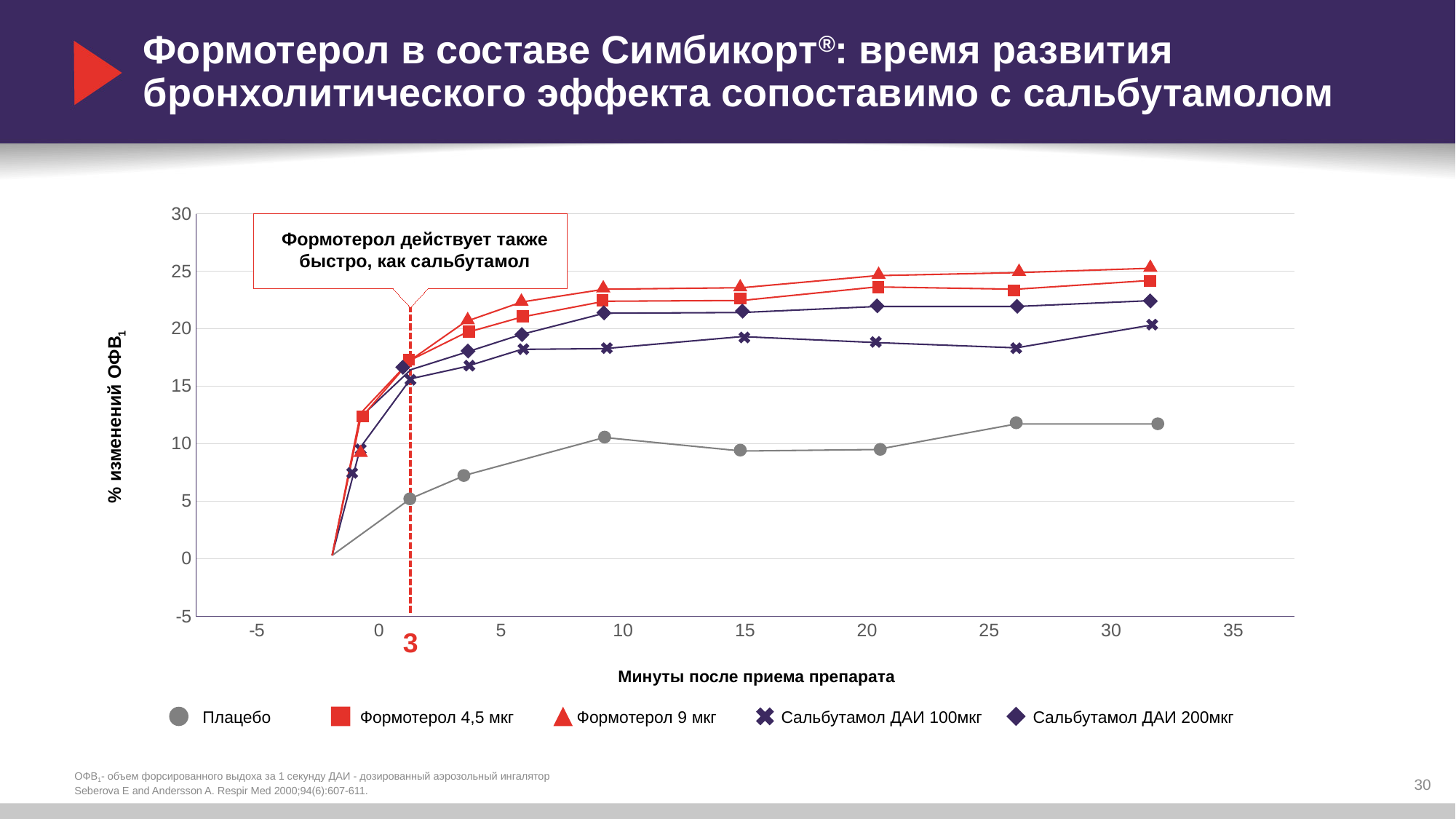
At 30 minutes, which is larger: Сальбутамол ДАИ 200мкг or Сальбутамол ДАИ 100мкг? Сальбутамол ДАИ 200мкг Is the value for Формотерол 9 мкг at 20 minutes greater or less than 20? greater Is the value for Плацебо at 30 minutes greater or less than 15? less What is the title of the x axis? Минуты после приема препарата Which series has the highest value at 30 minutes? Формотерол 9 мкг What kind of chart is shown on the slide? line chart Is the value for Сальбутамол ДАИ 100мкг at 25 minutes greater or less than 20? less Does the Плацебо series rise or fall between 0 and 10 minutes? rise How many series does the legend list? 5 Which series has the lowest values across the whole chart? Плацебо What value does the red dashed vertical line mark on the x axis? 3